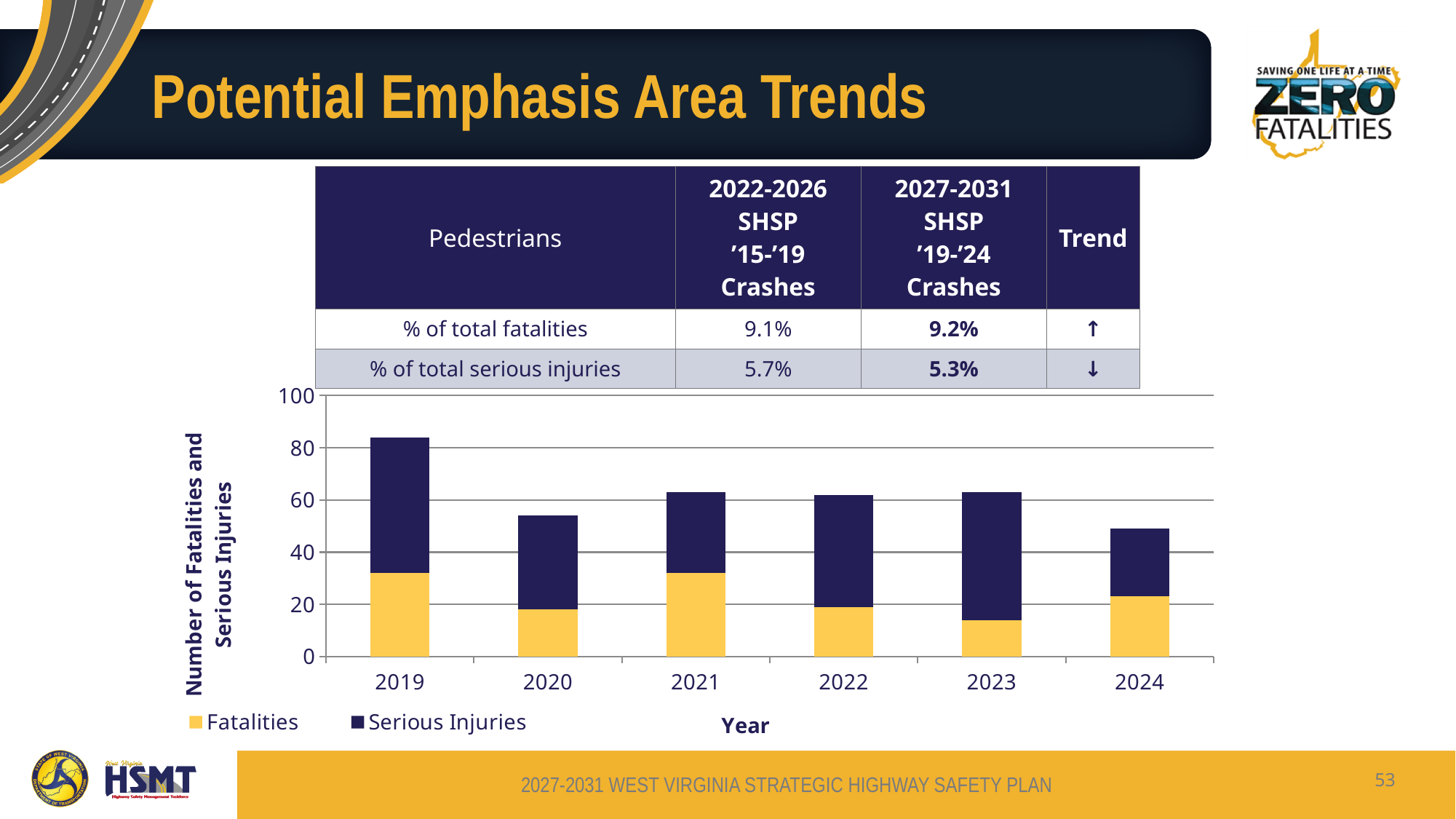
Which year has the shortest stacked bar (lowest combined fatalities and serious injuries)? 2024 Is the Fatalities value for 2021 greater or less than 20? greater What is the title of the x axis of the chart? Year How many years are shown on the x axis of the chart? 6 Which year has the larger total stacked bar, 2019 or 2020? 2019 How many series does the chart legend list? 2 Is the Fatalities value for 2023 greater or less than 20? less Is the total stacked bar for 2020 greater or less than 60? less What kind of chart is shown on the slide? Stacked bar chart Overall, do the stacked bar totals rise or fall from 2019 to 2024? fall Which year has the tallest stacked bar (highest combined fatalities and serious injuries)? 2019